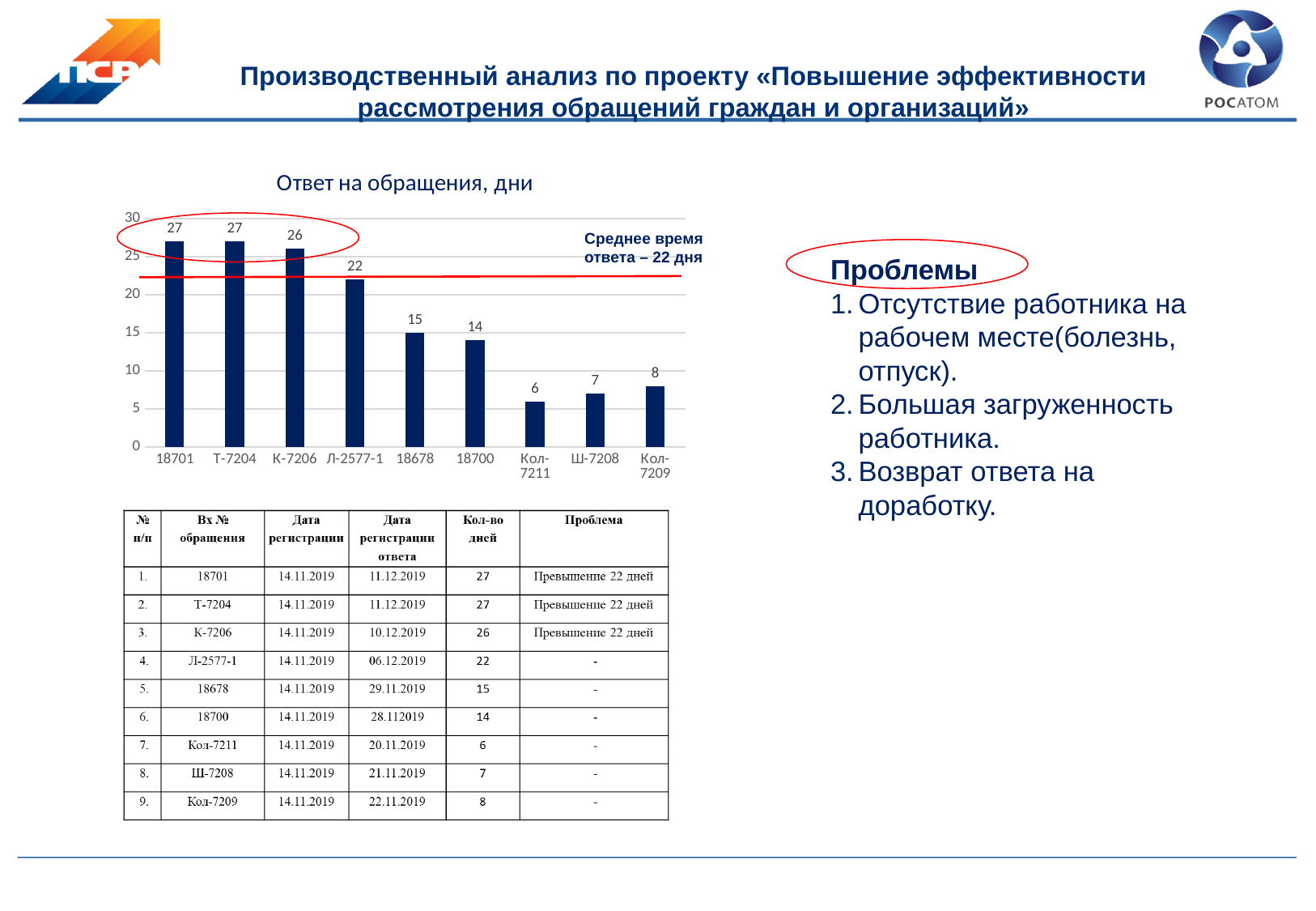
What average response time does the red horizontal line in the chart represent? 22 дня What is the value for 18678 in the chart? 15 What is the value for К-7206 in the chart? 26 Which category has the lowest value in the chart? Кол-7211 Is the value for Т-7204 greater or less than 25? greater What is the difference between the values for 18701 and 18700? 13 What type of chart is shown on the slide? bar chart What is the title of the chart? Ответ на обращения, дни What is the value for Л-2577-1 in the chart? 22 How many categories are plotted in the chart? 9 What is the value for Ш-7208 in the chart? 7 Which is larger, the value for 18678 or the value for Кол-7209? 18678